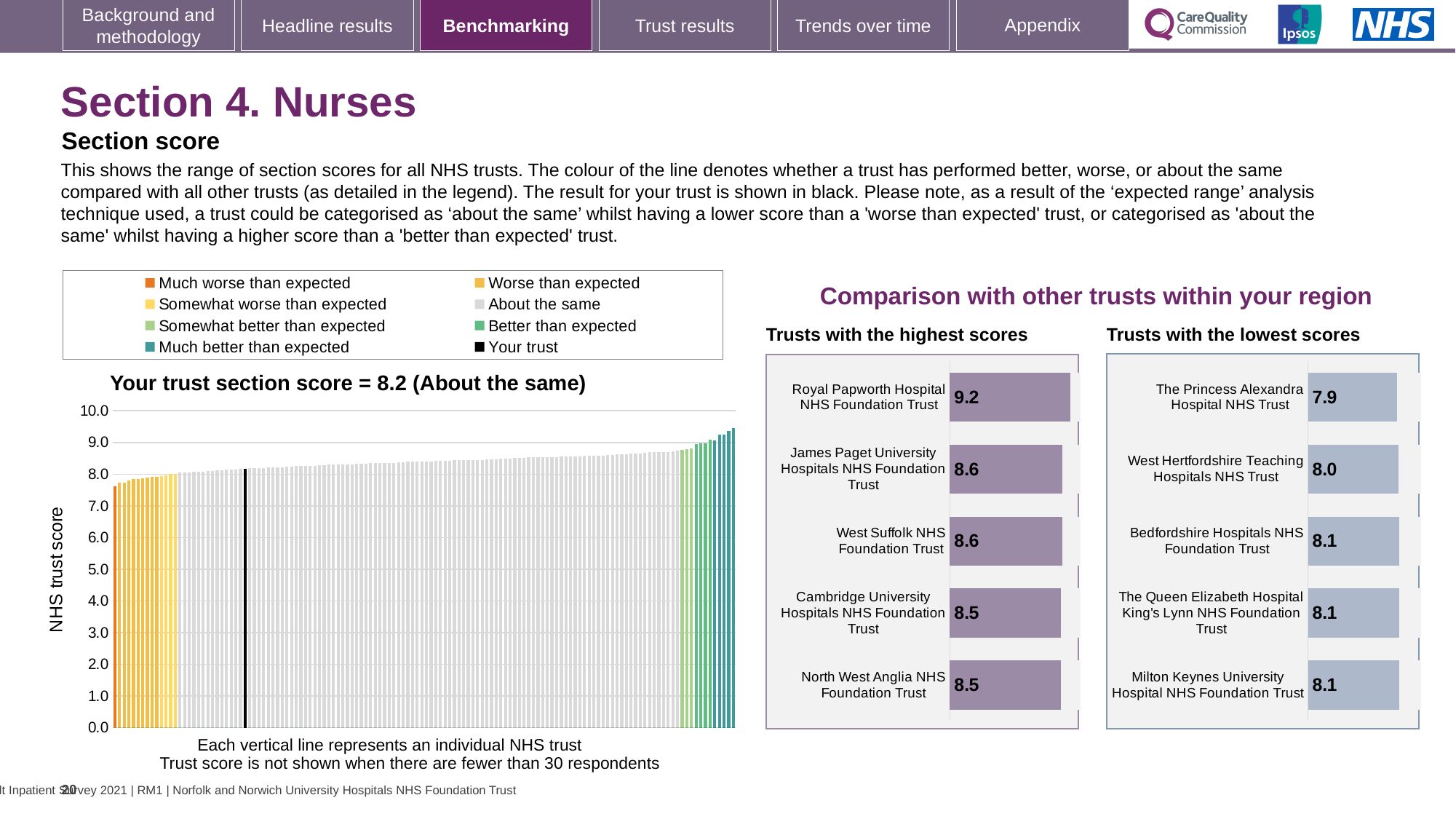
According to the main chart's title, what is your trust's section score for Nurses? 8.2 In the 'Trusts with the lowest scores' chart, what is the score for The Princess Alexandra Hospital NHS Trust? 7.9 How many entries does the legend above the main chart list? 8 How many trusts are shown in the 'Trusts with the highest scores' chart? 5 In the 'Trusts with the lowest scores' chart, what is the difference between the scores of Bedfordshire Hospitals NHS Foundation Trust and The Princess Alexandra Hospital NHS Trust? 0.2 In the 'Trusts with the lowest scores' chart, which trust has the lowest score? The Princess Alexandra Hospital NHS Trust What is the y-axis label of the main chart showing all NHS trusts? NHS trust score In the 'Trusts with the highest scores' chart, what is the score for Royal Papworth Hospital NHS Foundation Trust? 9.2 In the 'Trusts with the highest scores' chart, which trust has the highest score? Royal Papworth Hospital NHS Foundation Trust In the 'Trusts with the highest scores' chart, what is the difference between the scores of Royal Papworth Hospital NHS Foundation Trust and James Paget University Hospitals NHS Foundation Trust? 0.6 What kind of chart is the 'Trusts with the lowest scores' chart? Bar chart In the 'Trusts with the lowest scores' chart, which has the higher score: West Hertfordshire Teaching Hospitals NHS Trust or Bedfordshire Hospitals NHS Foundation Trust? Bedfordshire Hospitals NHS Foundation Trust